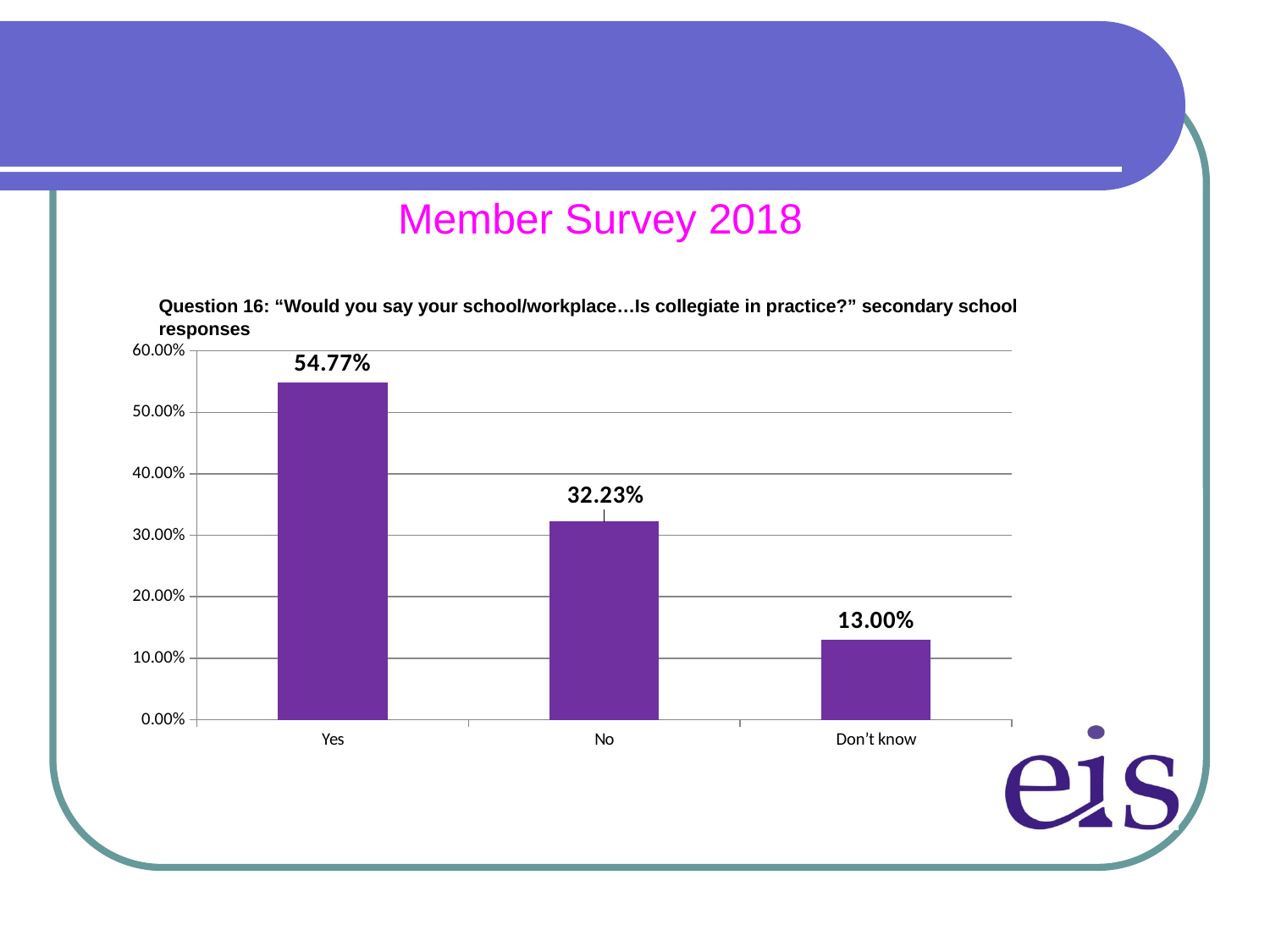
What is the value for "Yes"? 54.77% Do the values rise or fall from left to right along the x axis? fall Which is larger, the value for "No" or the value for "Don't know"? No How many categories are shown on the x axis? 3 Is the value for "Yes" greater or less than 50.00%? greater What is the difference between the values for "Yes" and "No"? 22.54% What kind of chart is shown on the slide? bar chart What is the value for "Don't know"? 13.00% What is the difference between the values for "No" and "Don't know"? 19.23% Which category has the lowest value? Don't know What is the value for "No"? 32.23% Which category has the highest value? Yes